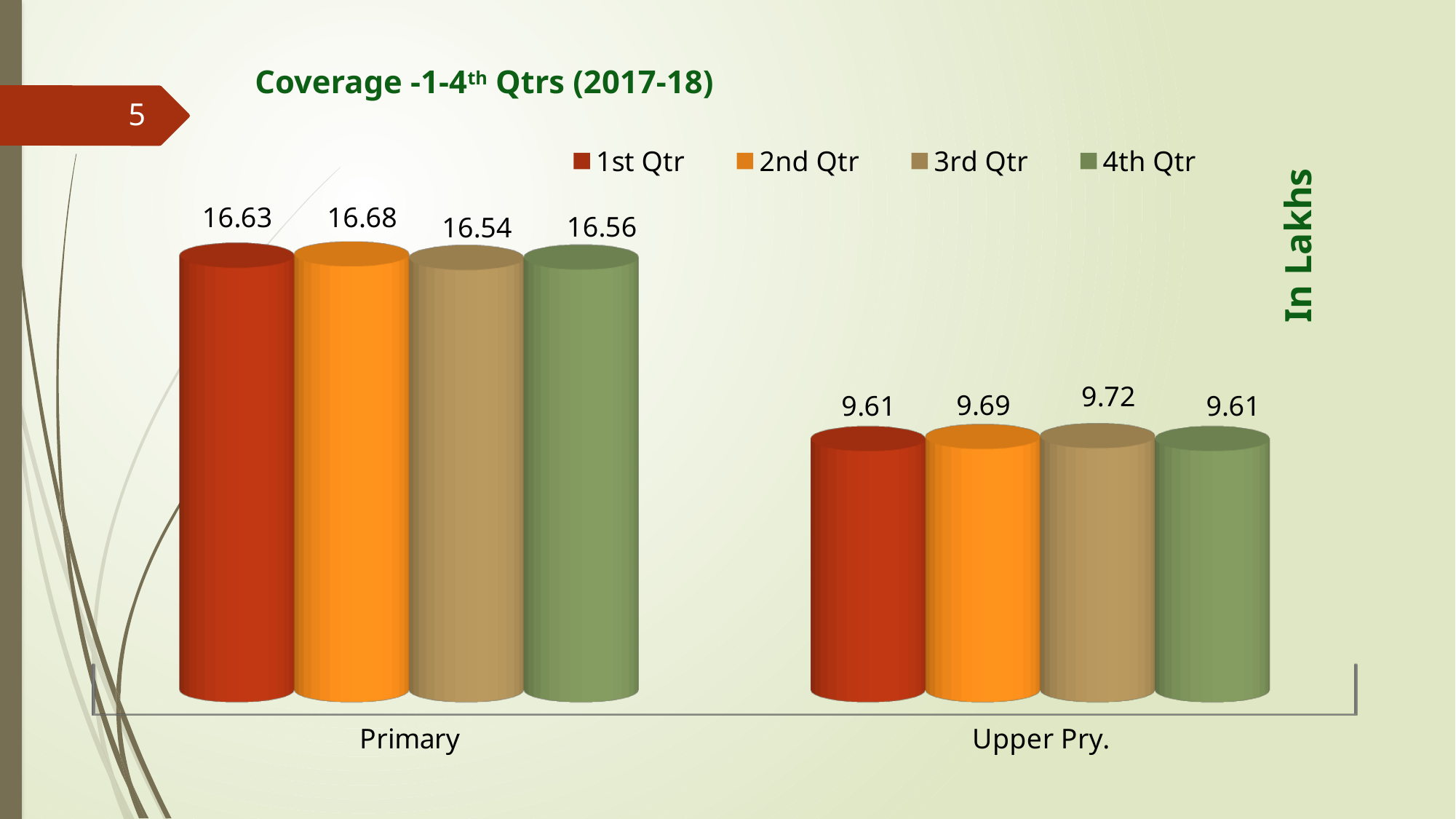
What kind of chart is shown on the slide? Bar chart What is the difference between the 2nd Qtr and 3rd Qtr values in the Primary category? 0.14 How many series does the legend list? 4 Which is larger: the 4th Qtr value for Primary or the 4th Qtr value for Upper Pry.? Primary What is the value for 2nd Qtr in the Upper Pry. category? 9.69 What is the value for 4th Qtr in the Primary category? 16.56 Which quarter has the highest value in the Upper Pry. category? 3rd Qtr What is the value for 1st Qtr in the Primary category? 16.63 Which quarter has the lowest value in the Primary category? 3rd Qtr What is the difference between the 1st Qtr values for Primary and Upper Pry.? 7.02 Which quarter has the highest value in the Primary category? 2nd Qtr What is the value for 3rd Qtr in the Upper Pry. category? 9.72